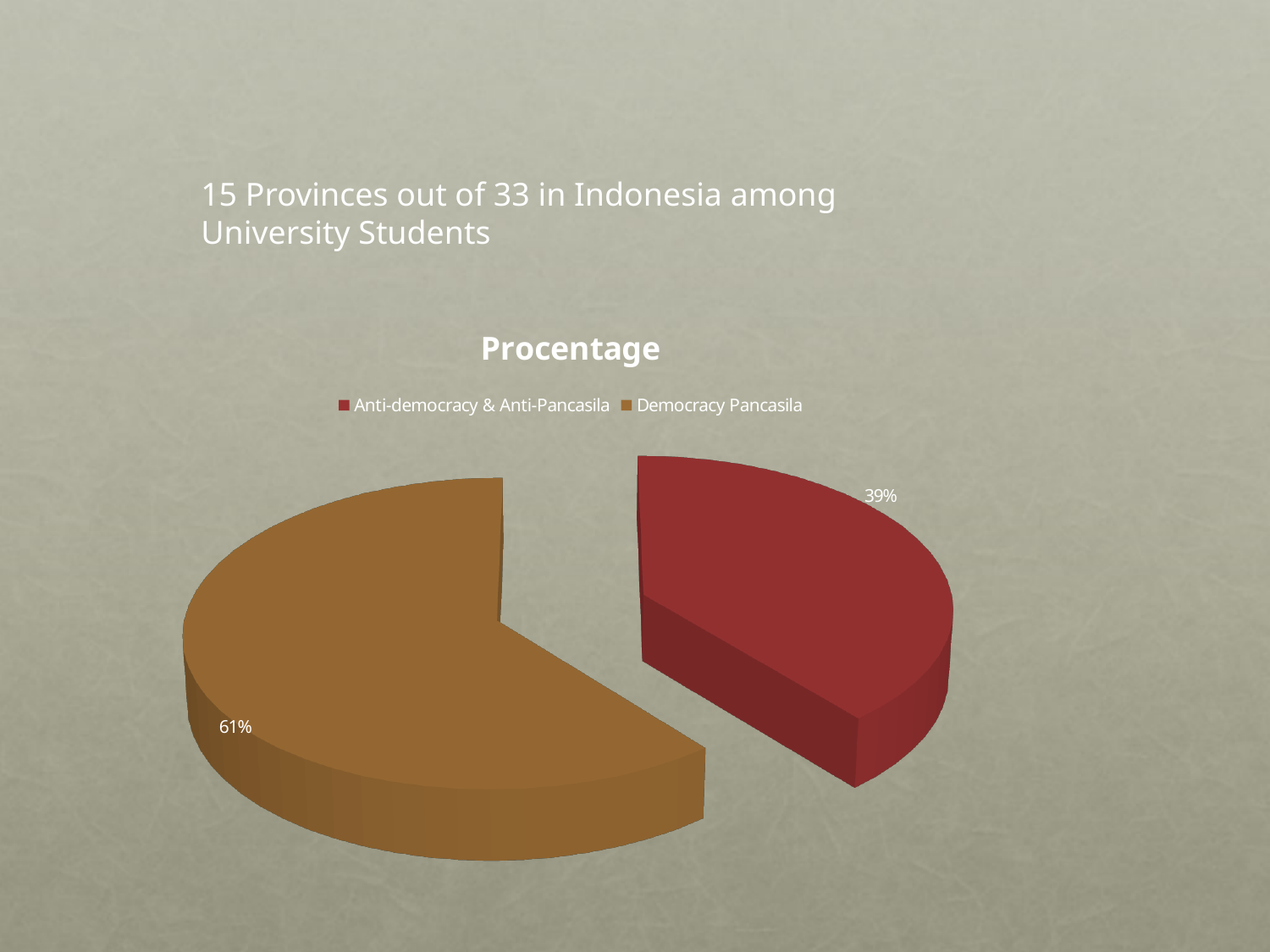
Which slice is the smallest? Anti-democracy & Anti-Pancasila How many slices does the pie chart have? 2 Is the share for Democracy Pancasila greater or less than 50%? greater Which colour represents Anti-democracy & Anti-Pancasila in the chart? red What is the difference in percentage points between Democracy Pancasila and Anti-democracy & Anti-Pancasila? 22 What share of the pie does Democracy Pancasila have? 61% How many entries does the legend list? 2 What is the chart's title? Procentage Which slice is the largest? Democracy Pancasila What share of the pie does Anti-democracy & Anti-Pancasila have? 39% What kind of chart is shown on the slide? pie chart Which is larger, Democracy Pancasila or Anti-democracy & Anti-Pancasila? Democracy Pancasila